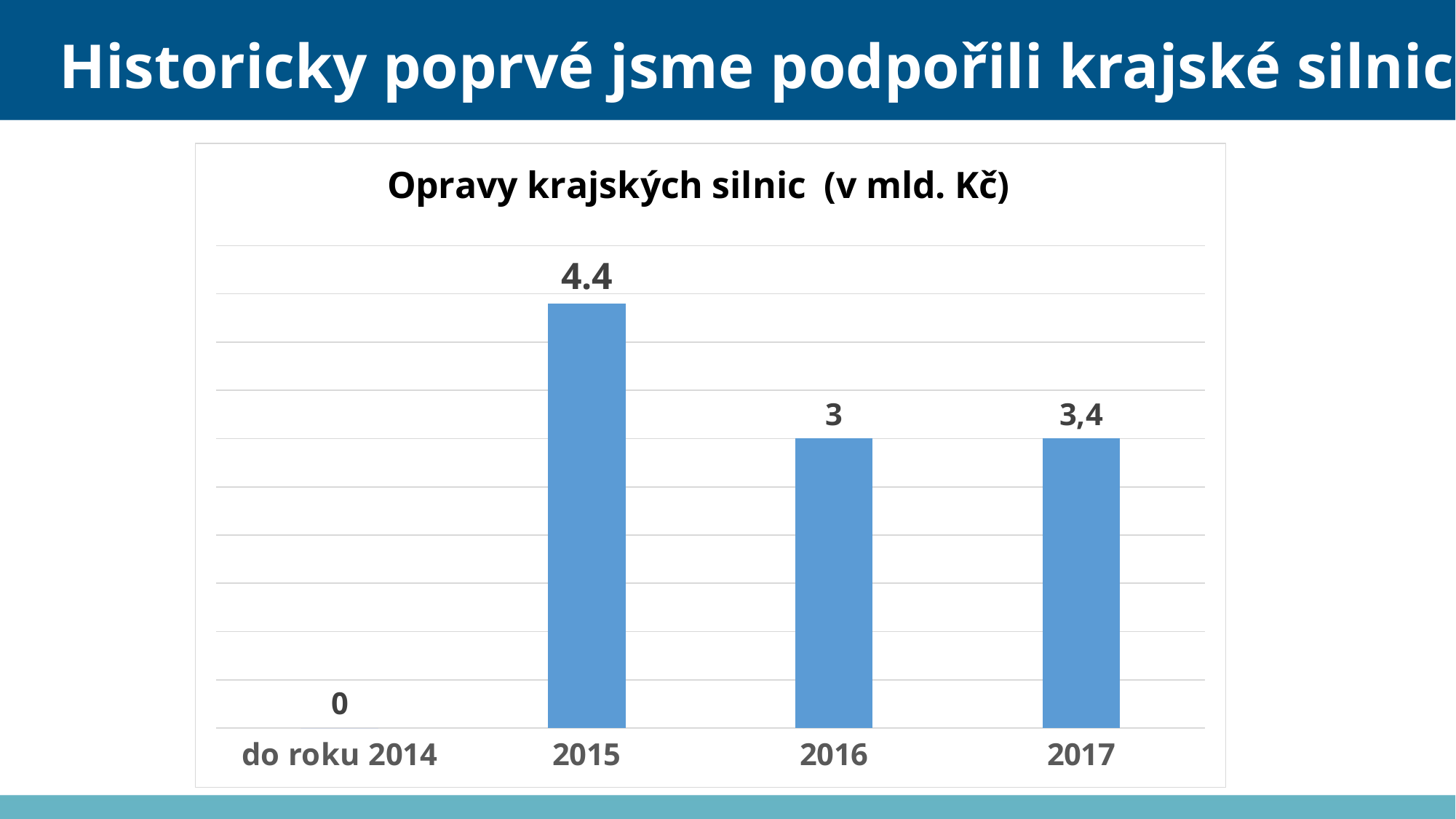
How many categories are shown on the x axis? 4 What is the title of the chart? Opravy krajských silnic (v mld. Kč) Which category has the highest value? 2015 What is the difference between the values for 2015 and 2016? 1.4 What is the value for 2016? 3 Which category has the lowest value? do roku 2014 What kind of chart is shown? bar chart What is the value for 2017? 3,4 What is the value for 2015? 4.4 What is the value for 'do roku 2014'? 0